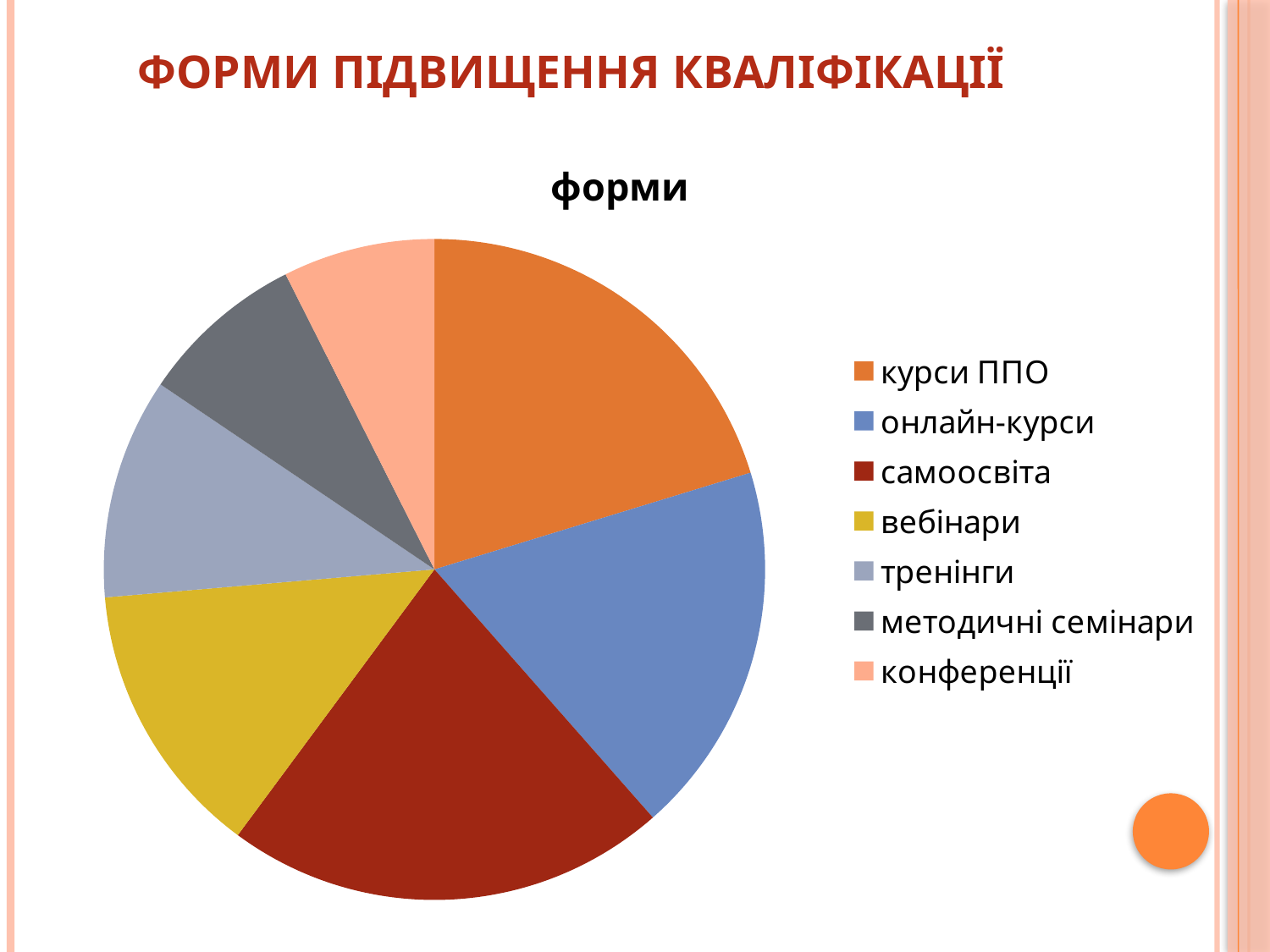
How many categories (slices) does the pie chart have? 7 Which slice is larger: вебінари or методичні семінари? вебінари What kind of chart is shown on the slide? pie chart What is the title of the pie chart? форми Which slice is larger: онлайн-курси or методичні семінари? онлайн-курси Which slice is larger: онлайн-курси or конференції? онлайн-курси Which category is shown in dark red in the pie chart? самоосвіта How many entries does the legend of the pie chart list? 7